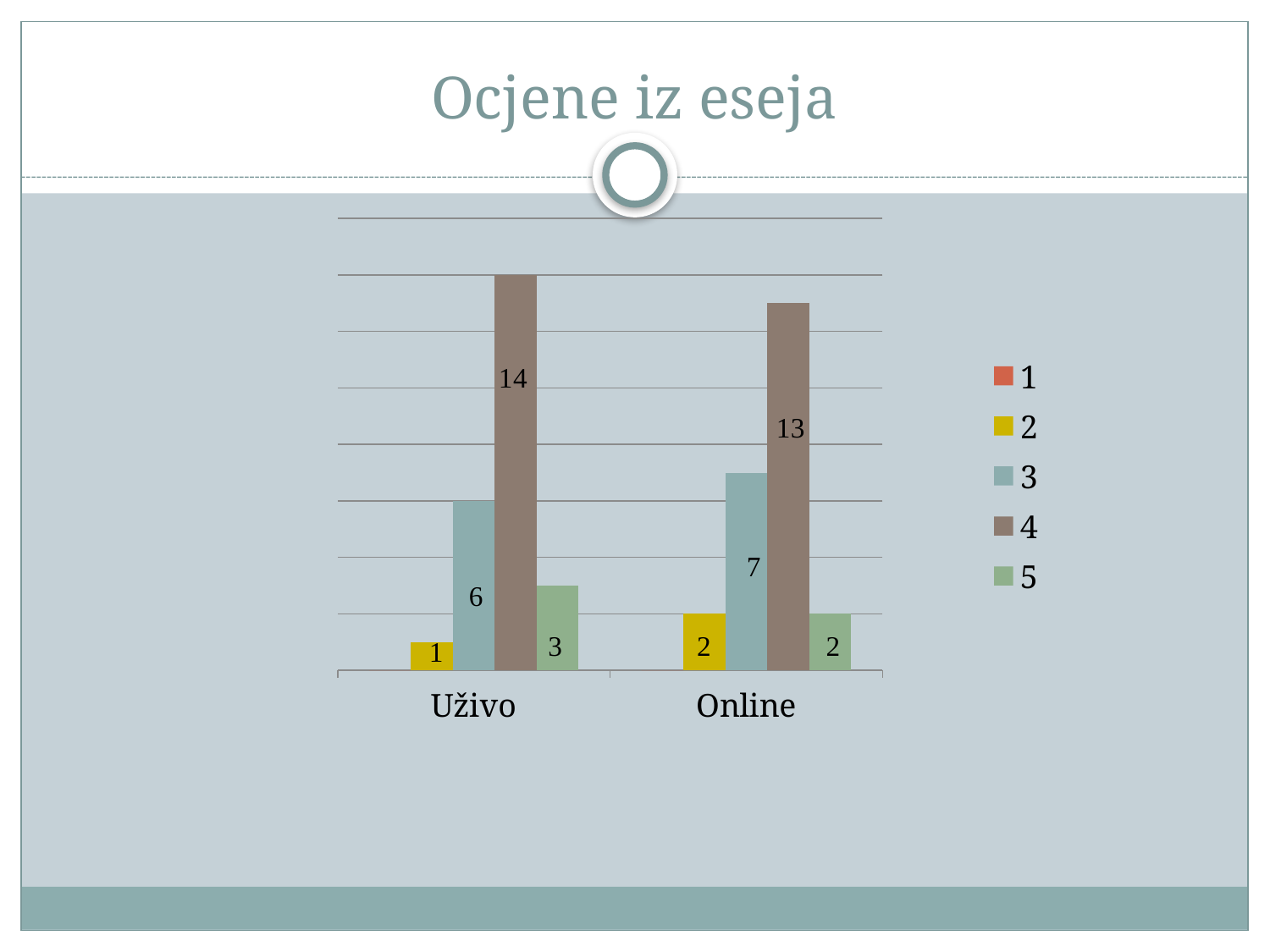
What is the value for grade 5 in the Online category? 2 Which grade has the highest value in the Online category? 4 What is the value for grade 3 in the Online category? 7 Which grade has the lowest labelled value in the Uživo category? 2 What is the title of the slide? Ocjene iz eseja How many series does the legend list? 5 How many categories are shown on the x axis? 2 What is the value for grade 4 in the Uživo category? 14 Which is larger: the grade 3 value for Uživo or for Online? Online What kind of chart is shown on the slide? Bar chart What is the value for grade 2 in the Uživo category? 1 What is the difference between the grade 4 values for Uživo and Online? 1